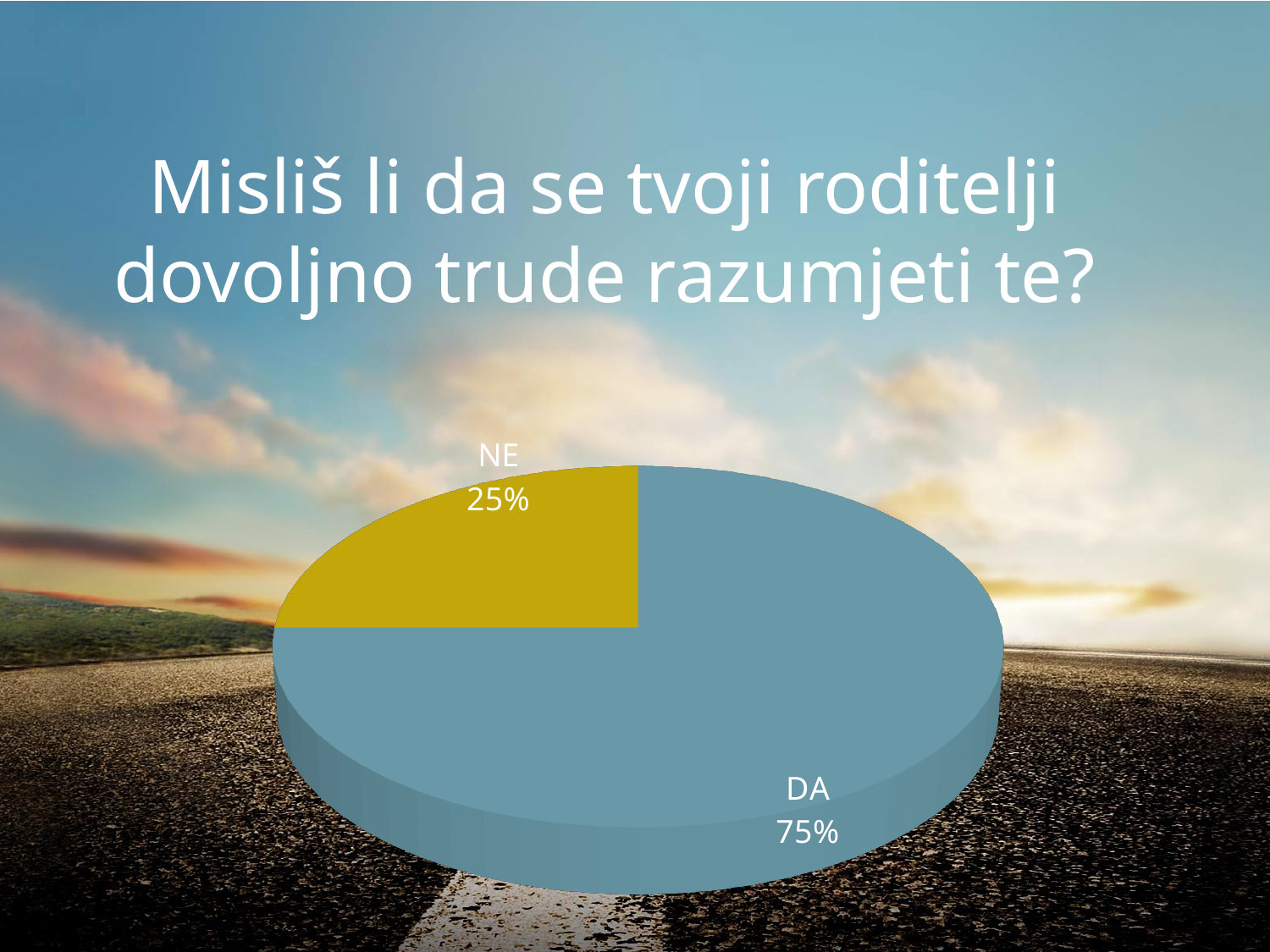
What percentage of respondents answered DA? 75% How many slices does the pie chart have? 2 Which slice is larger, DA or NE? DA Which answer has the largest share of the pie? DA What colour is the NE slice of the pie chart? yellow What is the title of the slide above the chart? Misliš li da se tvoji roditelji dovoljno trude razumjeti te? What kind of chart is shown on the slide? pie chart What share of the pie does the DA slice represent? 75% What is the difference in percentage points between the DA and NE slices? 50 Which answer has the smallest share of the pie? NE What percentage of respondents answered NE? 25%